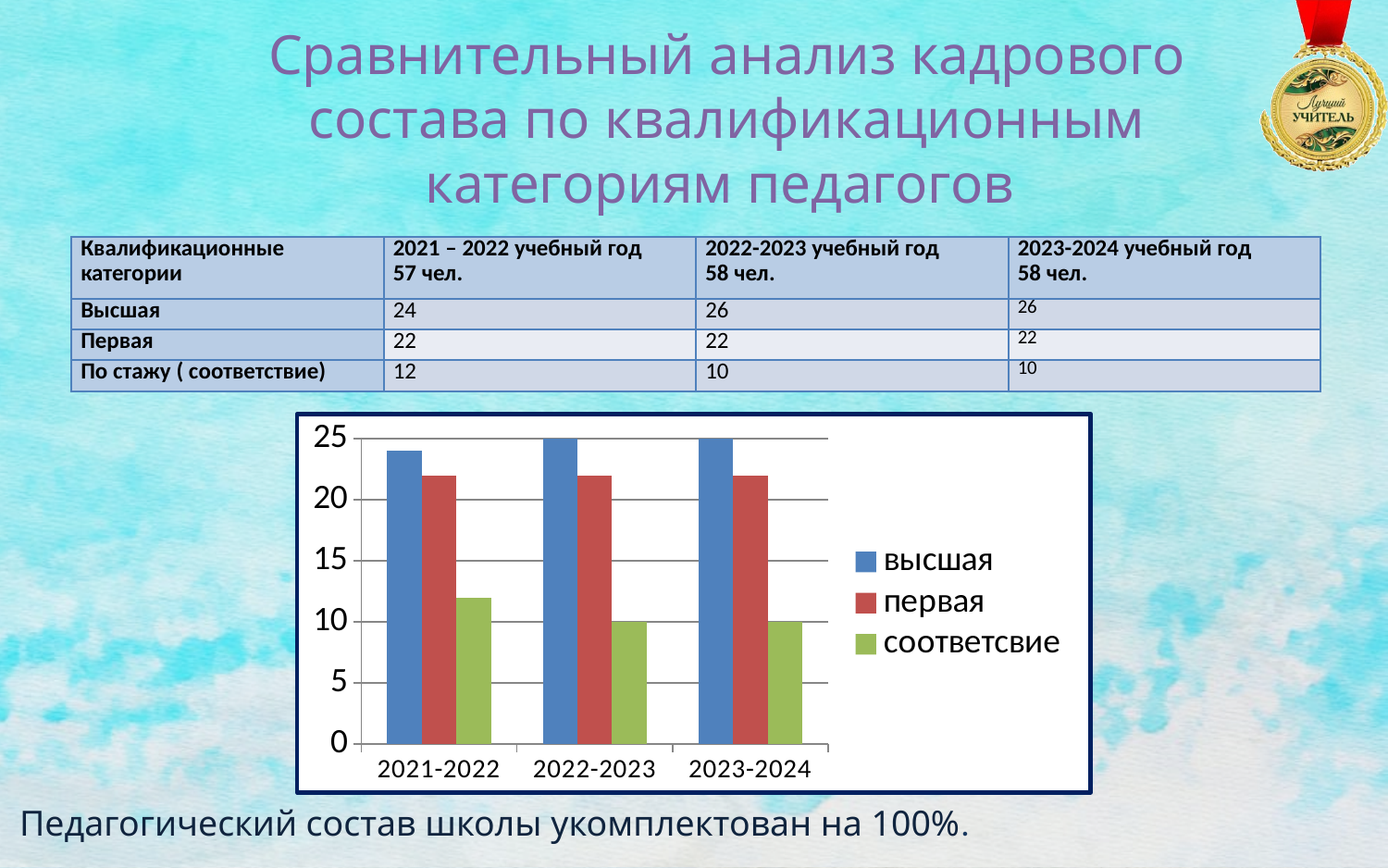
Which series has the lowest value in 2023-2024? соответсвие Does the value for соответсвие rise or fall from 2021-2022 to 2023-2024? fall Is the value for соответсвие in 2021-2022 greater or less than 10? greater What is the value of соответсвие for 2023-2024 in the chart? 10 How many year categories are shown on the x axis of the chart? 3 In 2021-2022, which is larger: высшая or первая? высшая Is the value for первая in 2021-2022 greater or less than 25? less What kind of chart is shown on the slide? bar chart How many series does the chart legend list? 3 What is the value of соответсвие for 2022-2023 in the chart? 10 Is the value for высшая in 2021-2022 greater or less than 20? greater In which year is the value for соответсвие the highest? 2021-2022